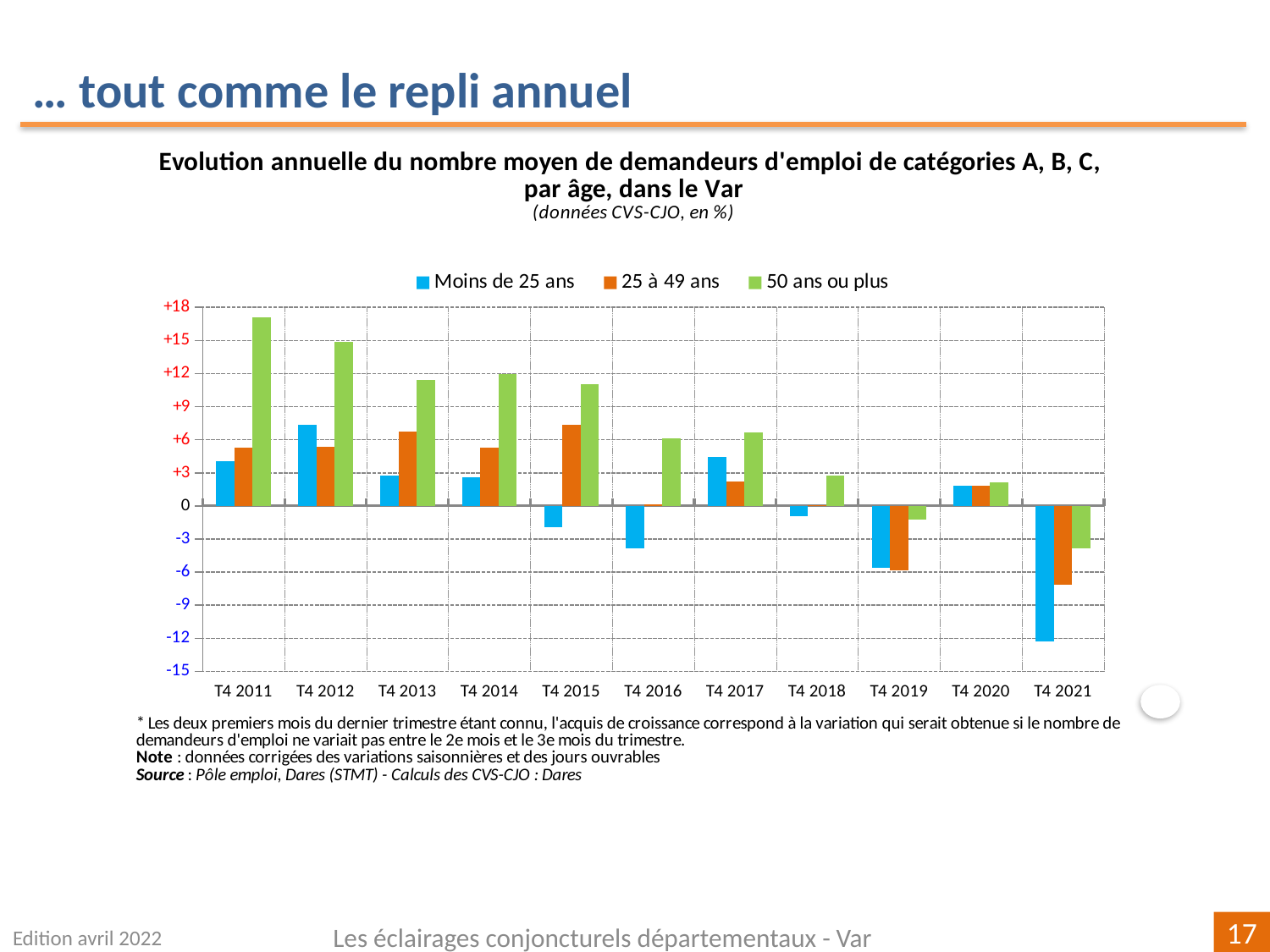
What kind of chart is shown on the slide? bar chart In which quarter is the value for '50 ans ou plus' the highest? T4 2011 In which quarter is the value for 'Moins de 25 ans' the lowest? T4 2021 Is the value for '50 ans ou plus' in T4 2013 greater or less than +9? greater How many quarters (categories) are shown on the x axis? 11 In T4 2015, which series has the larger value: 'Moins de 25 ans' or '25 à 49 ans'? 25 à 49 ans Overall, do the values for '50 ans ou plus' rise or fall from T4 2011 to T4 2021? fall In T4 2012, which series has the larger value: 'Moins de 25 ans' or '25 à 49 ans'? Moins de 25 ans Is the value for 'Moins de 25 ans' in T4 2021 greater or less than -9? less How many series does the legend list? 3 Which colour represents the '50 ans ou plus' series in the legend? green Is the value for '50 ans ou plus' in T4 2011 greater or less than +15? greater